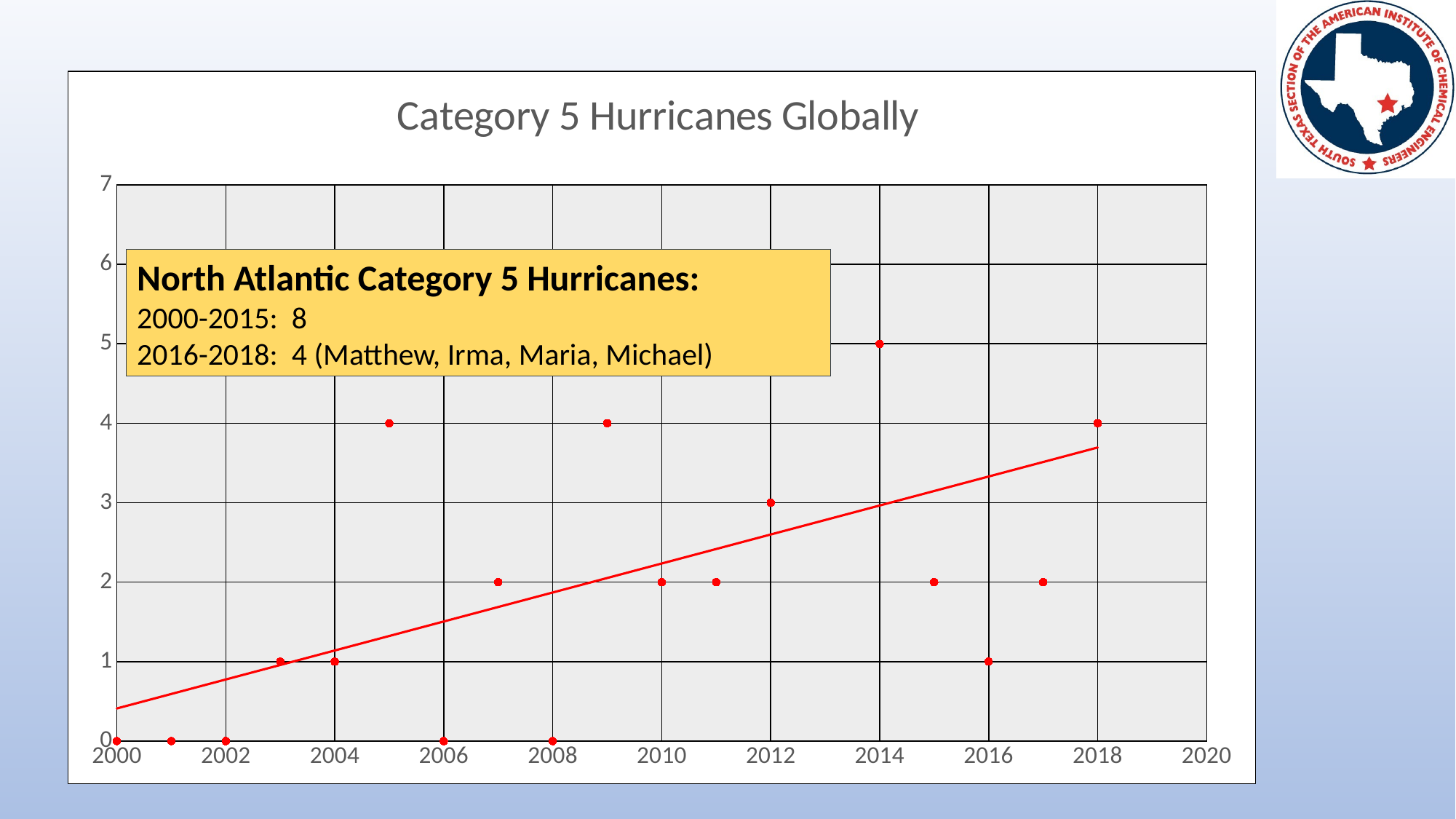
What is the value plotted for 2016? 1 According to the text box, how many North Atlantic Category 5 hurricanes occurred in 2016-2018? 4 What is the value plotted for 2018? 4 What kind of chart is shown on the slide? scatter chart What is the value plotted for 2005? 4 What is the value plotted for 2012? 3 What is the difference between the values for 2014 and 2016? 4 Does the trend line rise or fall from 2000 to 2018? rise What is the title of the chart? Category 5 Hurricanes Globally Which year has the larger value, 2009 or 2010? 2009 What is the value plotted for 2014? 5 What is the value plotted for 2008? 0